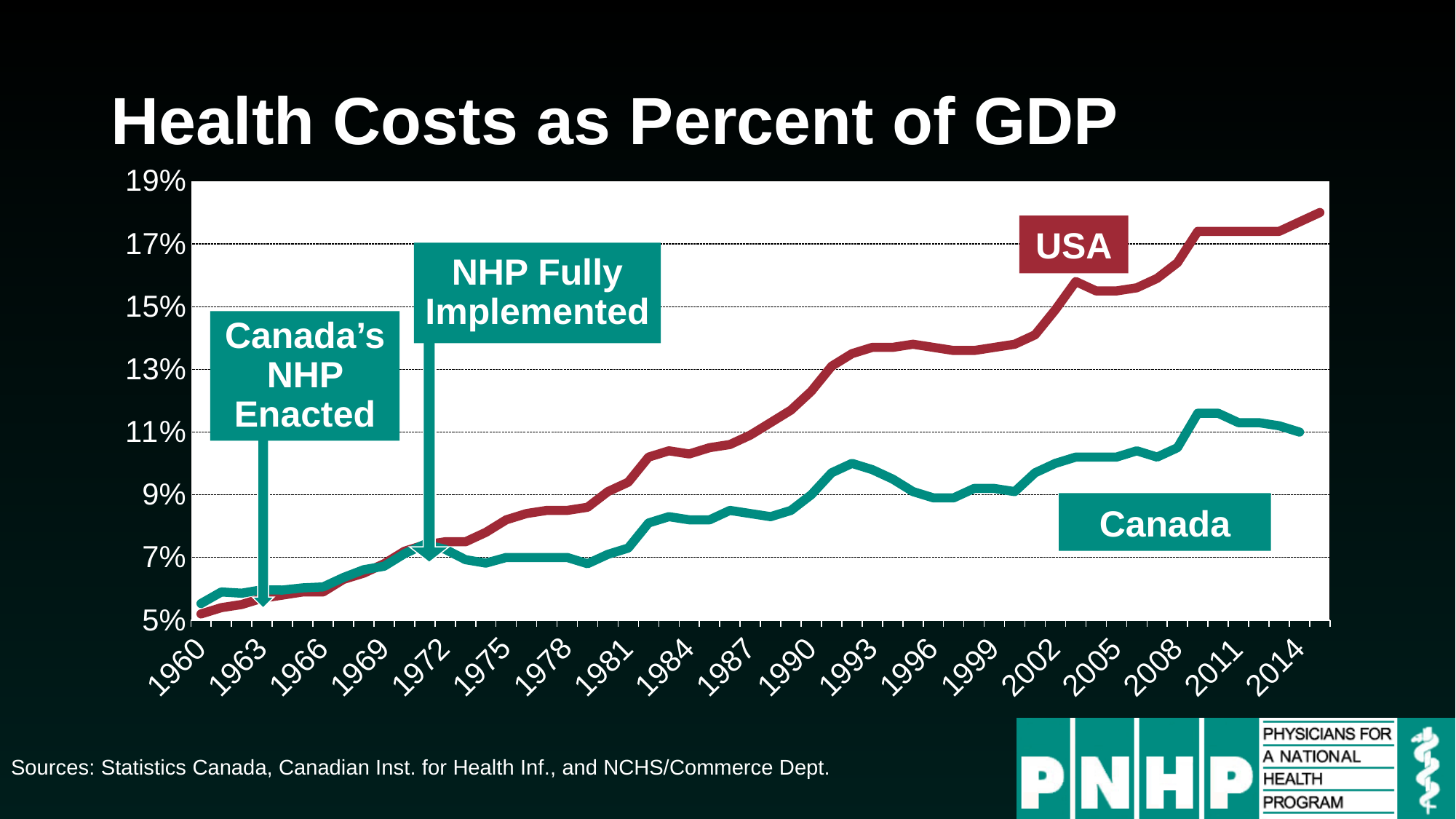
Is the value for USA in 1960 greater or less than 7%? less What event does the annotation near 1971 mark? NHP Fully Implemented Which series is higher in 2014, USA or Canada? USA Is the value for Canada in 1984 greater or less than 9%? less How many series are plotted on the chart? 2 Is the value for USA in 2014 greater or less than 17%? greater What is the title of the chart? Health Costs as Percent of GDP What kind of chart is shown on the slide? line chart Which series is higher in 1993, USA or Canada? USA Does the USA line generally rise or fall from 1960 to 2014? rise